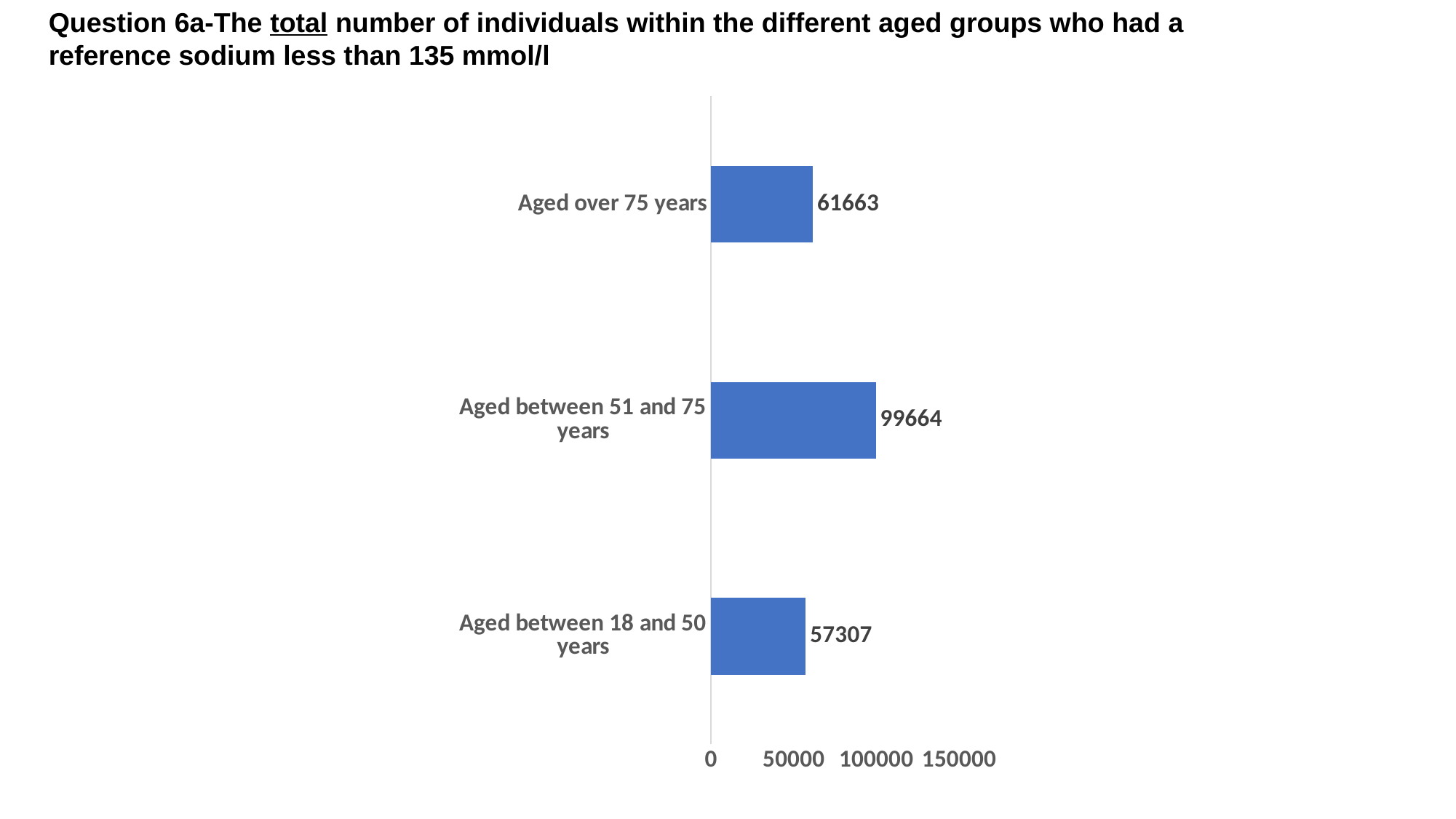
What kind of chart is shown on the slide? bar chart What is the difference between the values for Aged between 51 and 75 years and Aged over 75 years? 38001 What is the difference between the values for Aged over 75 years and Aged between 18 and 50 years? 4356 What is the highest tick value shown on the horizontal axis? 150000 How many age groups are shown in the chart? 3 What is the value for Aged between 51 and 75 years? 99664 Which age group has the highest value? Aged between 51 and 75 years Is the value for Aged between 51 and 75 years greater or less than 100000? less Which is larger, the value for Aged over 75 years or the value for Aged between 18 and 50 years? Aged over 75 years What is the value for Aged between 18 and 50 years? 57307 What is the value for Aged over 75 years? 61663 Which age group has the lowest value? Aged between 18 and 50 years